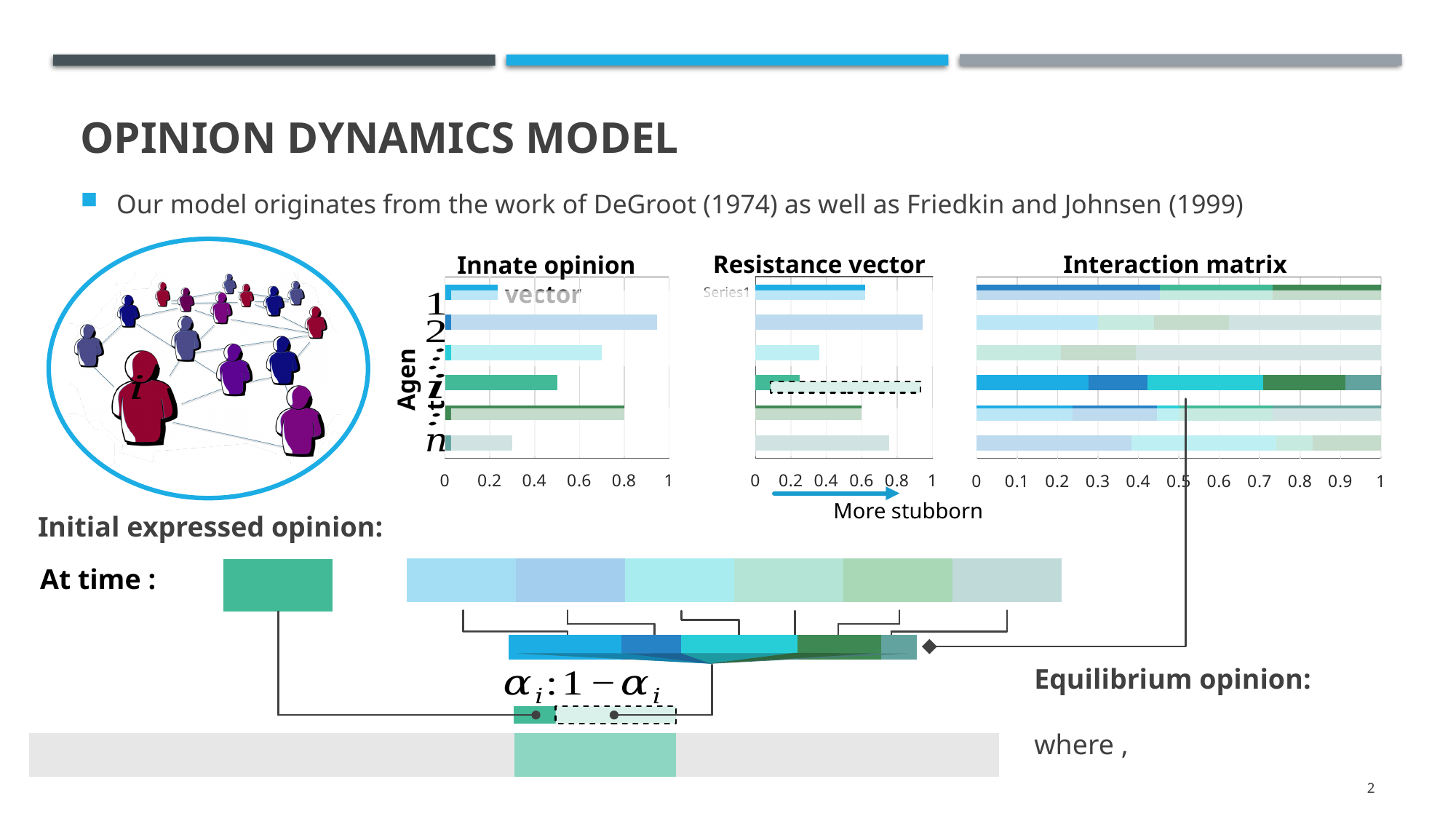
What text appears beneath the arrow under the Resistance vector chart's x axis? More stubborn In the Resistance vector chart, is the value of the third bar from the top greater or less than 0.6? less How many bars does the Innate opinion vector chart show? 6 In the Innate opinion vector chart, is the value for agent 1 greater or less than 0.4? less What kind of chart is the Interaction matrix chart? stacked bar chart In the Innate opinion vector chart, which agent has the highest value? 2 What is the maximum value shown on the x axis of the Resistance vector chart? 1 What kind of chart is the Innate opinion vector chart? bar chart In the Resistance vector chart, is the value of the second bar from the top greater or less than 0.8? greater In the Innate opinion vector chart, is the value for agent 2 larger or smaller than the value for agent n? larger How many stacked bars does the Interaction matrix chart show? 6